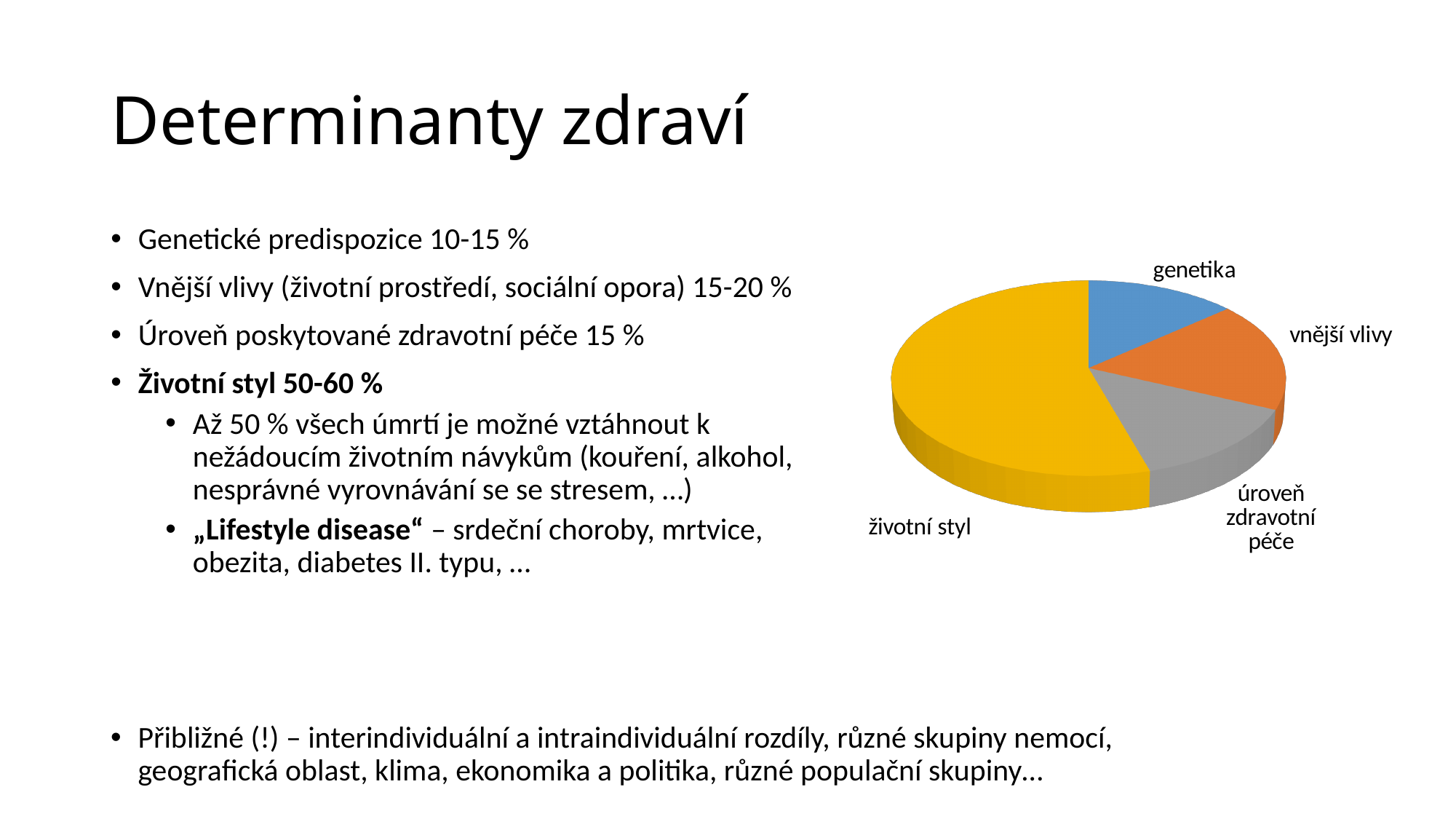
Does the slice for životní styl take up more or less than half of the pie chart? more Which is larger in the pie chart, the slice for životní styl or the slice for úroveň zdravotní péče? životní styl How many slices does the pie chart have? 4 Which is larger in the pie chart, the slice for životní styl or the slice for genetika? životní styl Which is larger in the pie chart, the slice for životní styl or the slice for vnější vlivy? životní styl Which category has the largest slice in the pie chart? životní styl What colour is the slice for životní styl in the pie chart? yellow What kind of chart is shown on the slide? pie chart What colour is the slice for genetika in the pie chart? blue